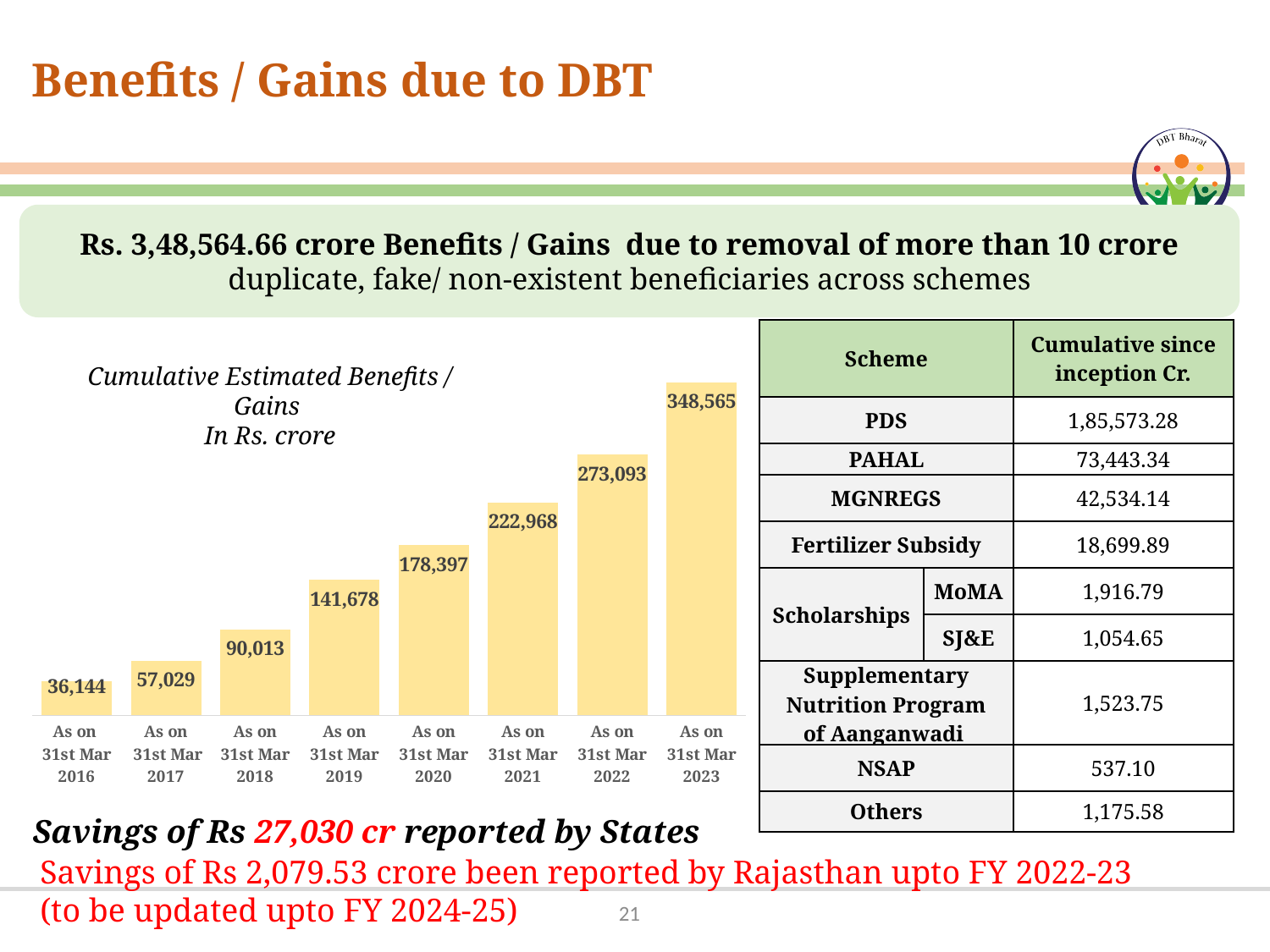
Which date has the highest cumulative estimated benefit? As on 31st Mar 2023 What is the difference between the values for 'As on 31st Mar 2023' and 'As on 31st Mar 2022'? 75,472 How many bars are plotted in the chart? 8 Which is larger, the value for 'As on 31st Mar 2020' or 'As on 31st Mar 2019'? As on 31st Mar 2020 What value is shown for 'As on 31st Mar 2019'? 141,678 What value is shown for 'As on 31st Mar 2021'? 222,968 What is the cumulative estimated benefit shown for 'As on 31st Mar 2023'? 348,565 What is the difference between the values for 'As on 31st Mar 2018' and 'As on 31st Mar 2017'? 32,984 Which date has the lowest cumulative estimated benefit? As on 31st Mar 2016 What type of chart is shown on the slide? Bar chart Do the values rise or fall from 2016 to 2023 along the x axis? Rise What value is shown for 'As on 31st Mar 2016'? 36,144